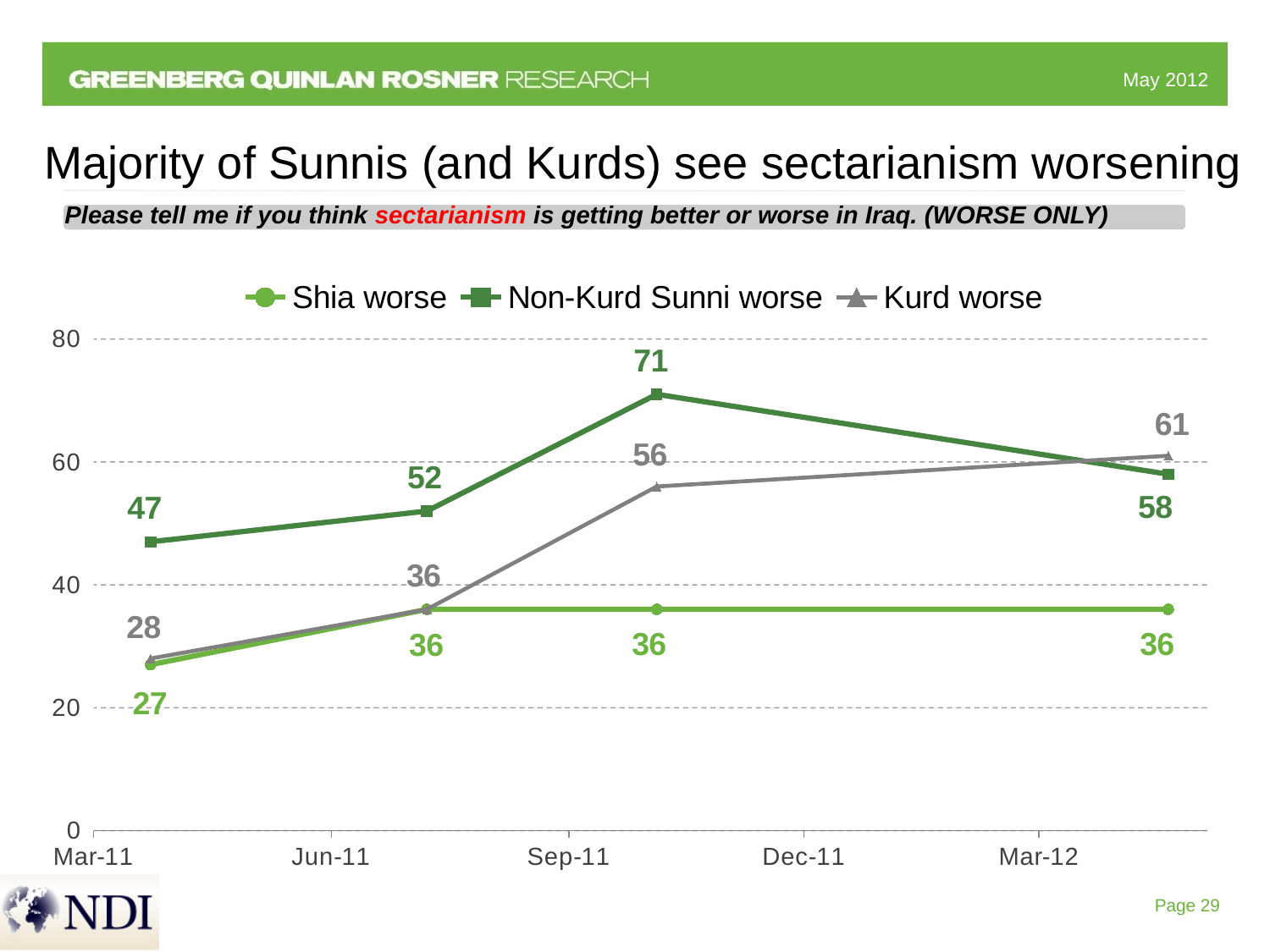
How many data points does each line have? 4 Which series is drawn with triangle markers? Kurd worse What is the value of the Kurd worse line at its last data point? 61 What is the highest value reached by the Non-Kurd Sunni worse line? 71 What is the value of the Non-Kurd Sunni worse line at its first data point? 47 Does the Shia worse line rise, fall, or stay flat over its last three data points? stays flat What kind of chart is shown on the slide? line chart What is the lowest value shown on the Kurd worse line? 28 What is the difference between the peak of the Non-Kurd Sunni worse line (71) and its last value (58)? 13 At the last data point, which is larger: Kurd worse or Non-Kurd Sunni worse? Kurd worse What is the value of the Shia worse line at its first data point? 27 How many series does the legend list? 3